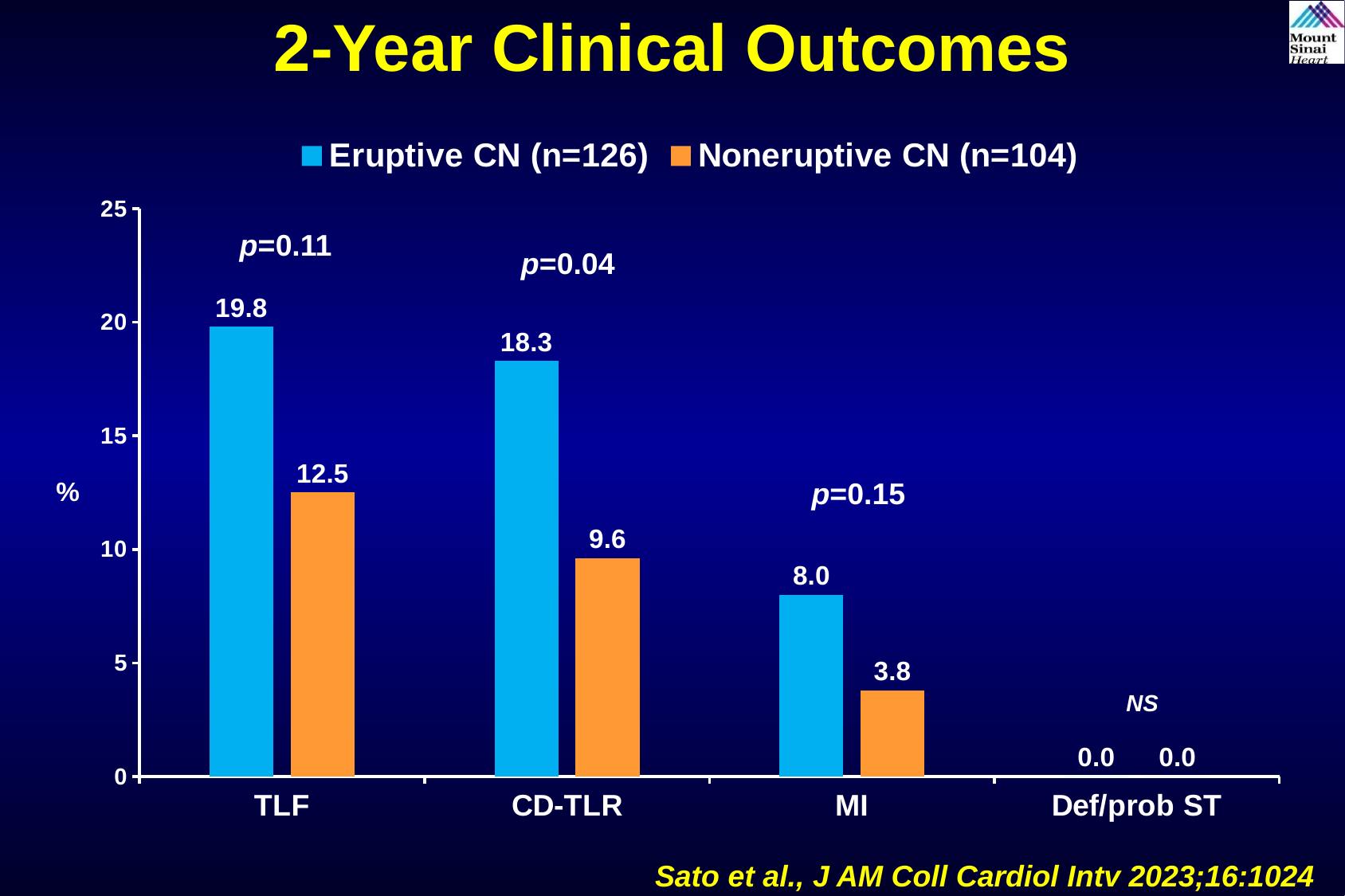
What is the value for Noneruptive CN (n=104) for CD-TLR? 9.6 What is the value for Noneruptive CN (n=104) for MI? 3.8 What kind of chart is shown on the slide? Bar chart What is the difference between the Eruptive CN and Noneruptive CN values for TLF? 7.3 What is the difference between the Eruptive CN and Noneruptive CN values for CD-TLR? 8.7 How many series does the legend list? 2 What is the value for Eruptive CN (n=126) for TLF? 19.8 How many categories are shown on the x axis? 4 Which category has the lowest value for Noneruptive CN (n=104)? Def/prob ST Which category has the highest value for Eruptive CN (n=126)? TLF Which is larger for MI: the Eruptive CN (n=126) value or the Noneruptive CN (n=104) value? Eruptive CN (n=126) What p-value is shown above the CD-TLR bars? p=0.04